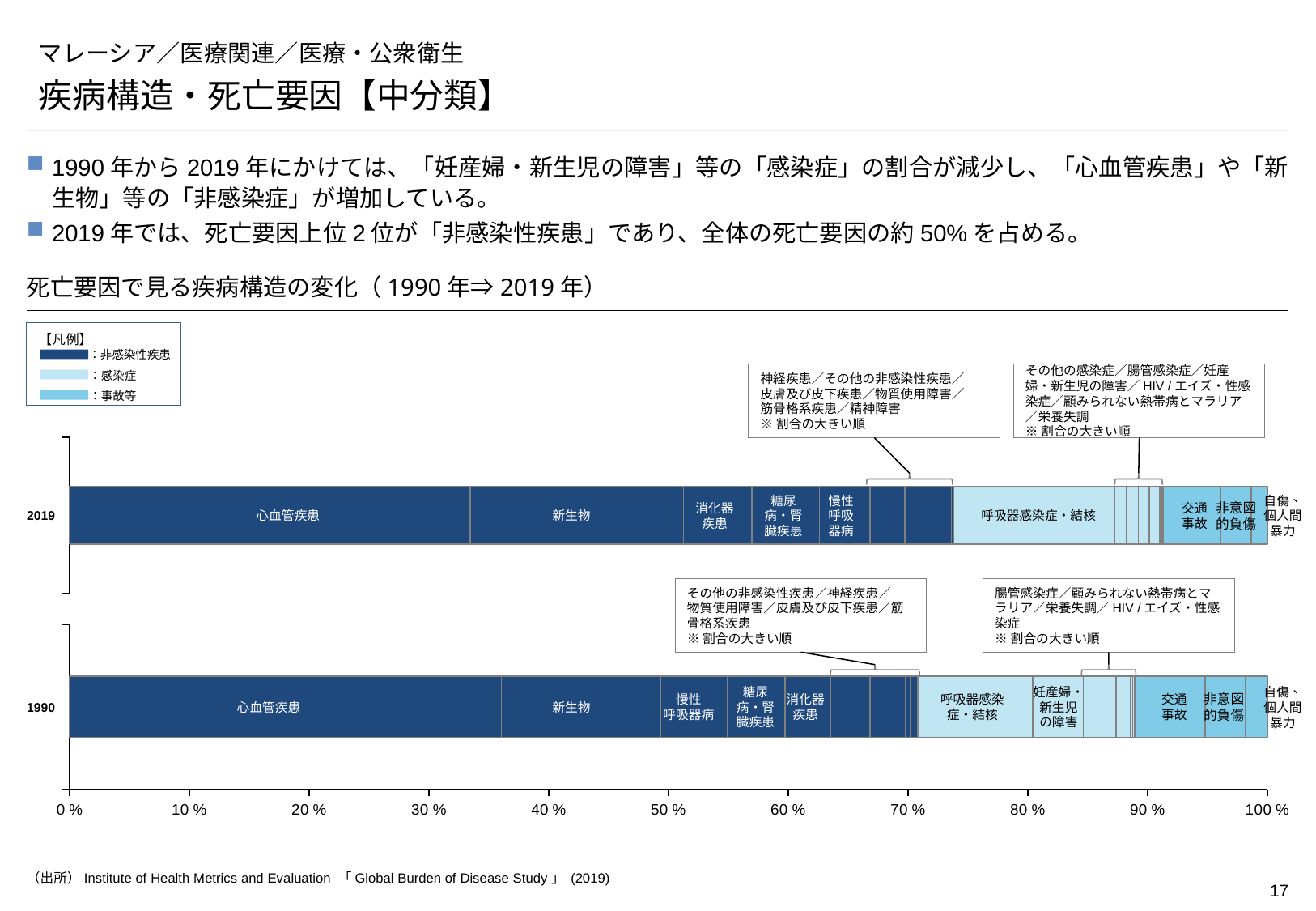
Is the share of 妊産婦・新生児の障害 in 1990 greater or less than 10%? less Which legend category is shown in dark blue? 非感染性疾患 Is the share of 心血管疾患 in 1990 greater or less than 40%? less How many entries does the legend (凡例) list? 3 Which year has the larger share for 新生物, 1990 or 2019? 2019 Which category has the largest share in the 2019 bar? 心血管疾患 How many bars (years) are plotted in the chart? 2 Which two years are compared in the chart? 1990 and 2019 What kind of chart is shown on the slide? Stacked bar chart Which category has the largest share in the 1990 bar? 心血管疾患 Is the share of 呼吸器感染症・結核 in 2019 greater or less than 10%? greater